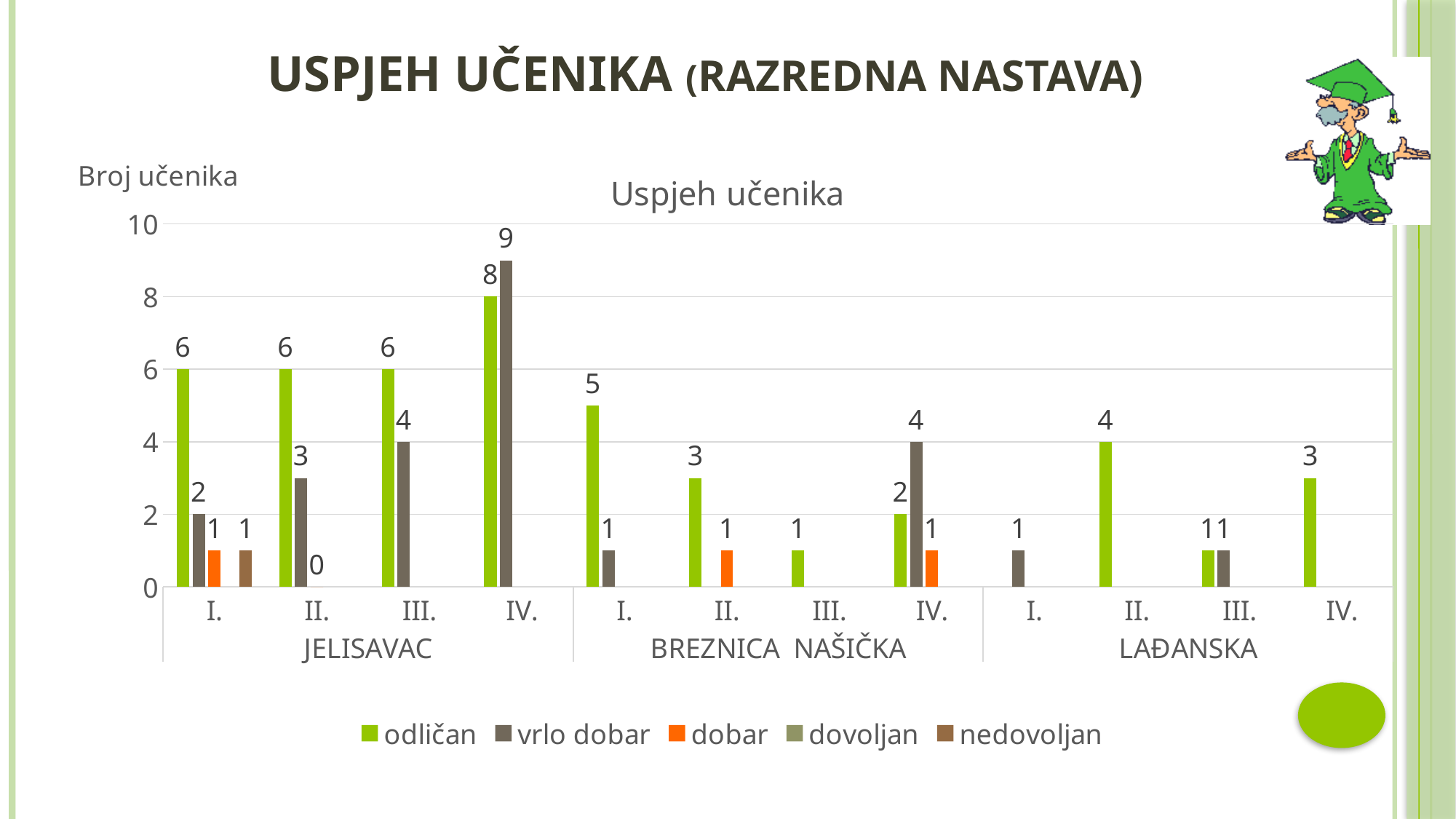
Which is larger for class III. in JELISAVAC: 'odličan' or 'vrlo dobar'? odličan What is the value of 'odličan' for class I. in BREZNICA NAŠIČKA? 5 What is the value of 'odličan' for class IV. in JELISAVAC? 8 What is the value of 'vrlo dobar' for class IV. in BREZNICA NAŠIČKA? 4 What is the value of 'vrlo dobar' for class IV. in JELISAVAC? 9 What kind of chart is shown on the slide? bar chart What is the title of the chart? Uspjeh učenika How many series does the legend of the chart list? 5 Which school and class has the highest 'vrlo dobar' value? JELISAVAC IV. What is the value of 'odličan' for class II. in LAĐANSKA? 4 What is the difference between the 'vrlo dobar' and 'odličan' values for class IV. in JELISAVAC? 1 What is the label of the vertical axis? Broj učenika